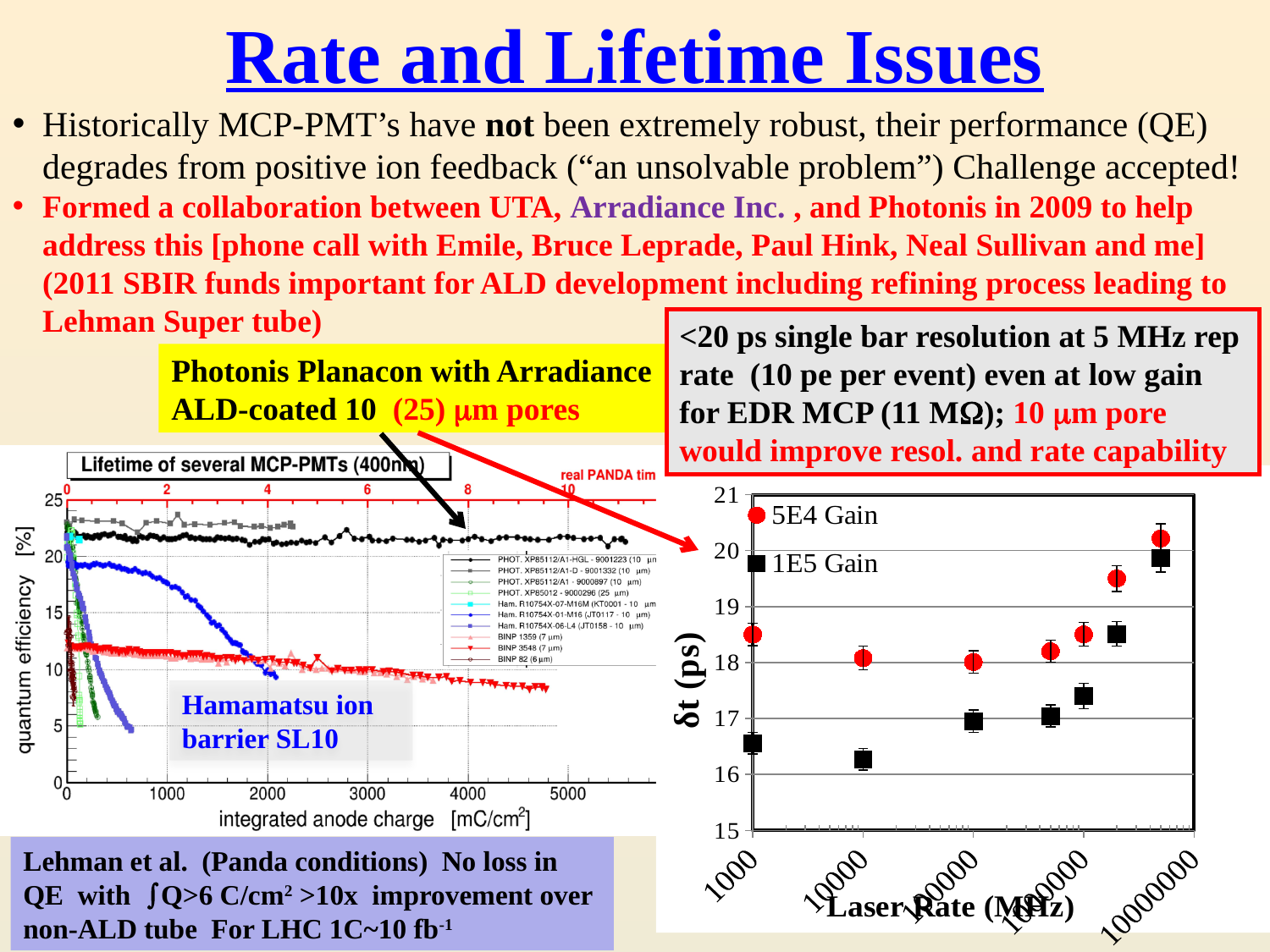
What kind of chart is the left-hand chart titled 'Lifetime of several MCP-PMTs (400nm)'? line chart What is the title of the left-hand chart? Lifetime of several MCP-PMTs (400nm) In the right-hand chart (δt vs Laser Rate), how many data points are plotted for the 1E5 Gain series? 7 In the right-hand chart (δt vs Laser Rate), does the 1E5 Gain series overall rise or fall as the laser rate increases? rise In the left-hand chart 'Lifetime of several MCP-PMTs (400nm)', is the quantum efficiency of the topmost curve at 5000 mC/cm² greater or less than 20? greater How many series does the legend of the right-hand chart (δt vs Laser Rate) list? 2 In the right-hand chart (δt vs Laser Rate), at which laser rate does the 1E5 Gain series reach its highest δt? the highest laser rate (rightmost point) What kind of chart is the right-hand chart plotting δt against Laser Rate? scatter chart In the right-hand chart (δt vs Laser Rate), at the lowest laser rate, is the δt value for 1E5 Gain greater or less than 17? less In the right-hand chart (δt vs Laser Rate), at the lowest laser rate, is the δt value for 5E4 Gain greater or less than 18? greater In the right-hand chart (δt vs Laser Rate), at the lowest laser rate, which series has the larger δt, 5E4 Gain or 1E5 Gain? 5E4 Gain What are the two series named in the legend of the right-hand chart (δt vs Laser Rate)? 5E4 Gain and 1E5 Gain